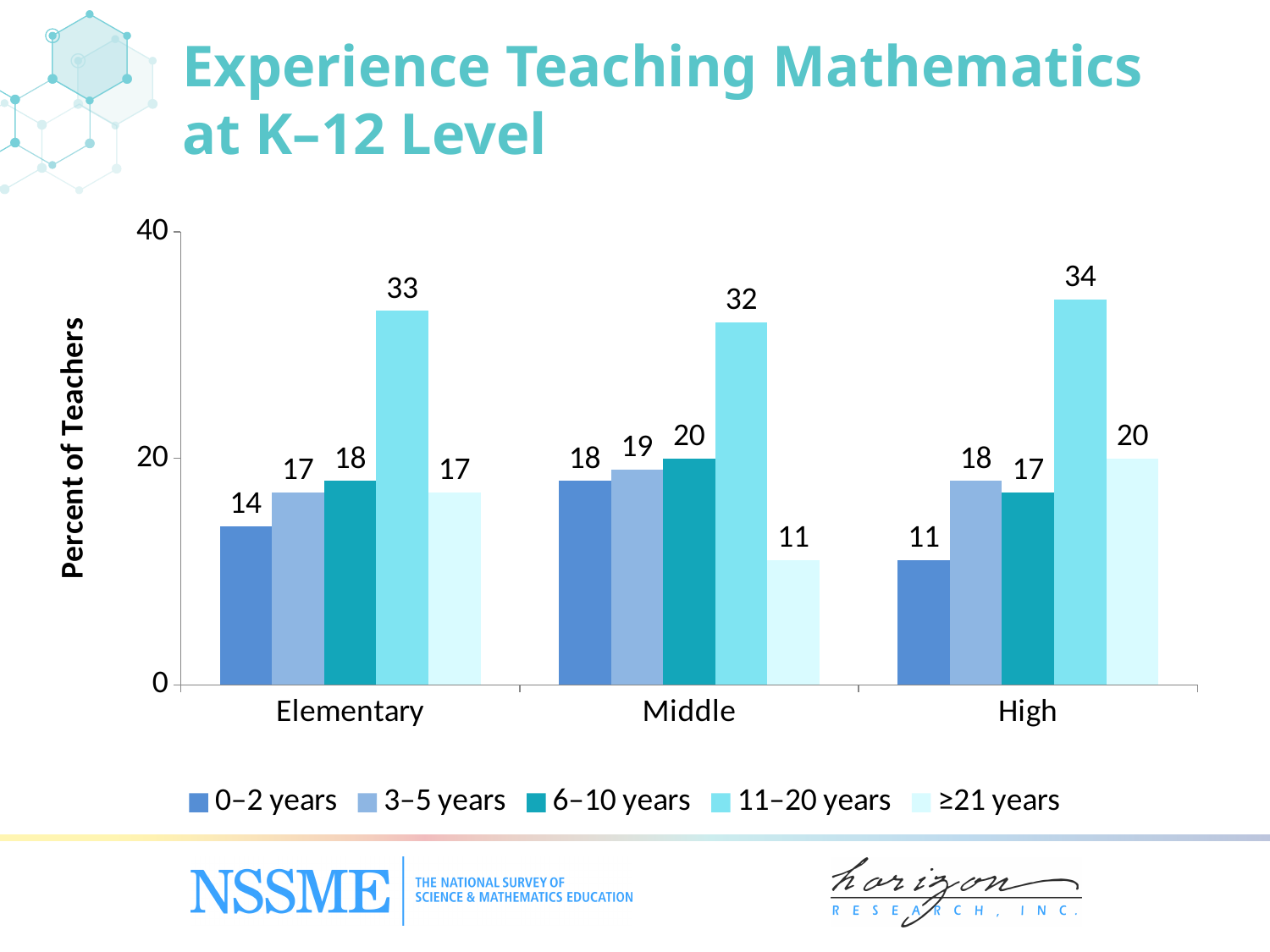
What kind of chart is shown on the slide? bar chart What is the label of the y axis? Percent of Teachers What is the difference between the 11–20 years value for High and the 11–20 years value for Elementary? 1 Which experience category has the highest value among High school teachers? 11–20 years What is the value for the ≥21 years series in the Middle category? 11 What percent of elementary teachers have 11–20 years of experience teaching mathematics? 33 Which experience category has the lowest value among Elementary teachers? 0–2 years What is the value for the 0–2 years series in the High category? 11 What is the difference between the ≥21 years values for High and Middle? 9 How many grade-level categories are shown on the x axis? 3 How many series does the legend list? 5 Which is larger: the 0–2 years value for Middle or the 0–2 years value for Elementary? Middle